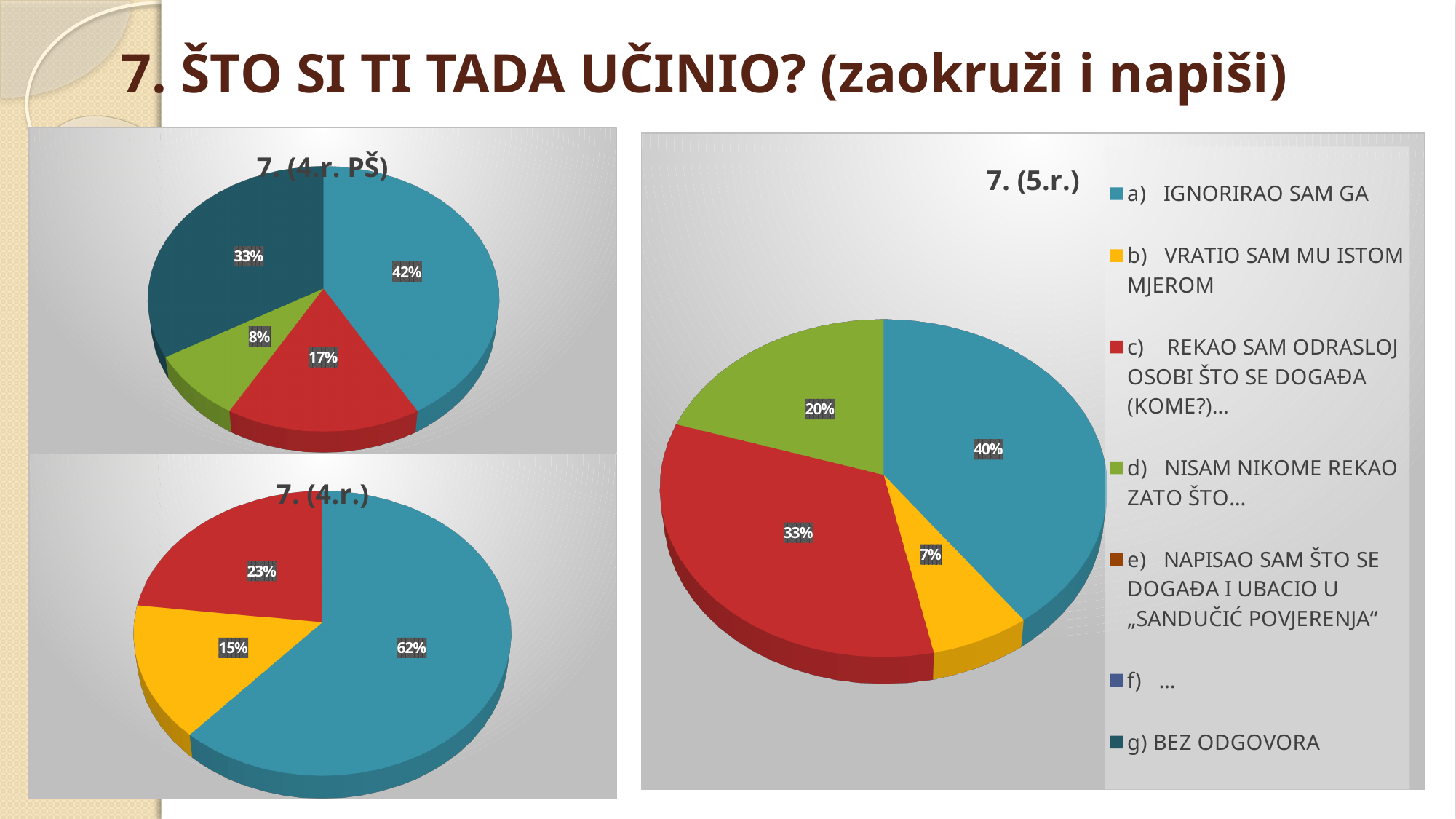
In the chart titled "7. (4.r. PŠ)", what percentage is shown on the green slice? 8% In the chart titled "7. (5.r.)", how many slices does the pie have? 4 How many entries does the legend of the chart titled "7. (5.r.)" list? 7 In the chart titled "7. (4.r.)", what is the largest percentage shown? 62% In the chart titled "7. (5.r.)", what is the difference in percentage points between a) IGNORIRAO SAM GA and d) NISAM NIKOME REKAO ZATO ŠTO…? 20 In the chart titled "7. (5.r.)", which legend category has the smallest slice? b) VRATIO SAM MU ISTOM MJEROM In the chart titled "7. (4.r. PŠ)", which is larger: the light blue slice or the dark teal slice? the light blue slice In the chart titled "7. (5.r.)", what percentage is shown for a) IGNORIRAO SAM GA? 40% In the chart titled "7. (4.r. PŠ)", what is the difference in percentage points between the red slice and the green slice? 9 In the chart titled "7. (5.r.)", what percentage is shown for c) REKAO SAM ODRASLOJ OSOBI ŠTO SE DOGAĐA (KOME?)…? 33% What type of chart is the chart titled "7. (4.r.)"? pie chart In the chart titled "7. (4.r.)", how many slices does the pie have? 3